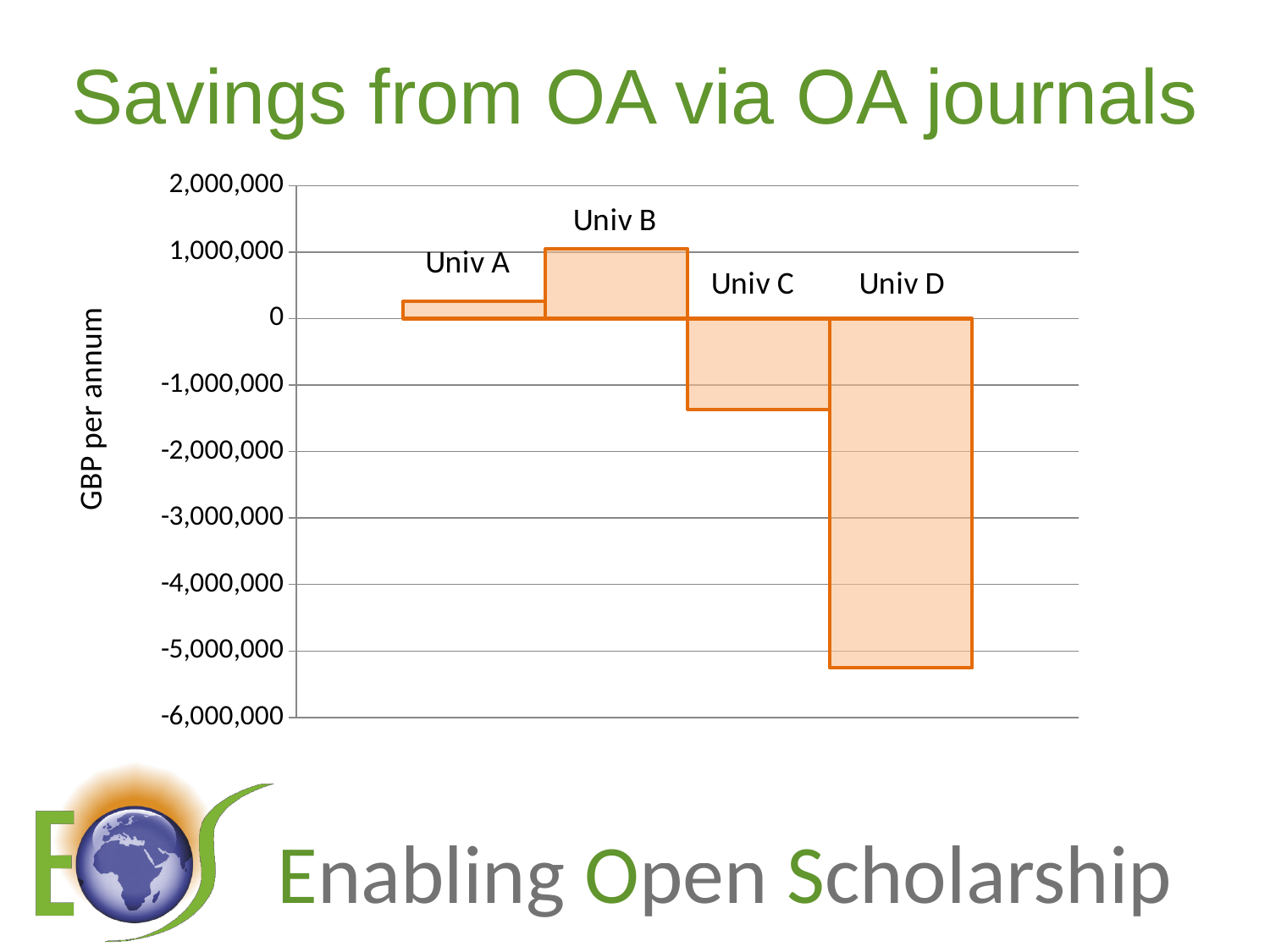
What kind of chart is shown on the slide? bar chart Is the value for Univ D greater or less than -4,000,000? less Which university has the lowest value in the chart? Univ D Is the value for Univ B greater or less than 0? greater Which has the larger value, Univ A or Univ C? Univ A Which has the larger value, Univ C or Univ D? Univ C What is the label on the vertical axis of the chart? GBP per annum Is the value for Univ A greater or less than 1,000,000? less What is the title of the chart on the slide? Savings from OA via OA journals How many universities are plotted in the chart? 4 Which university has the highest value in the chart? Univ B